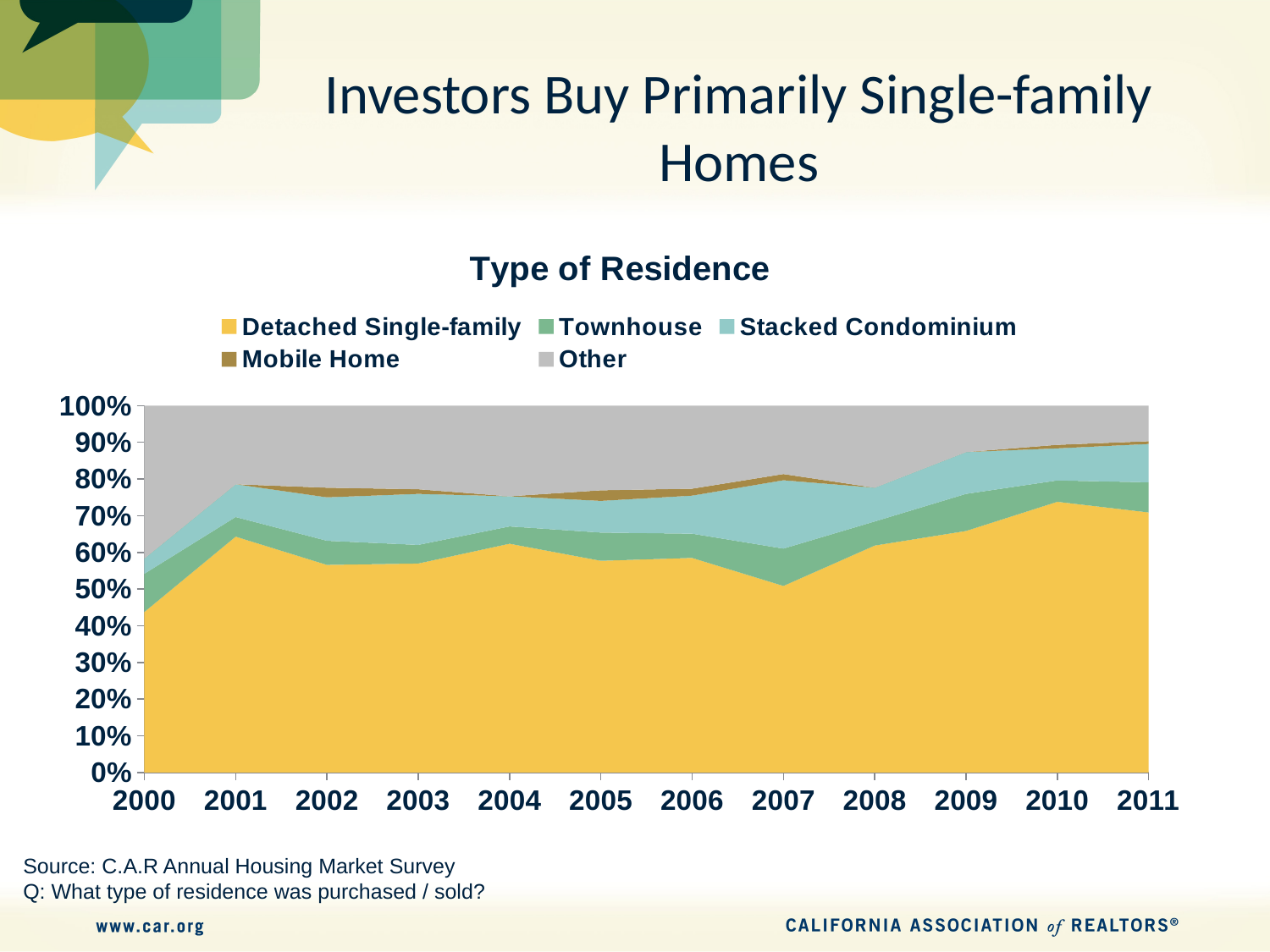
Is the Detached Single-family share in 2010 greater or less than 70%? greater What kind of chart is shown on the slide? Stacked area chart Is the Detached Single-family share in 2000 greater or less than 50%? less Is the Detached Single-family share in 2001 greater or less than 60%? greater What is the title of the chart? Type of Residence Which series is shown in yellow? Detached Single-family How many series does the legend list? 5 Which year has the larger Detached Single-family share, 2000 or 2011? 2011 How many years are shown along the x axis? 12 In which year is the Detached Single-family share lowest? 2000 Does the Detached Single-family share rise or fall from 2007 to 2010? rise